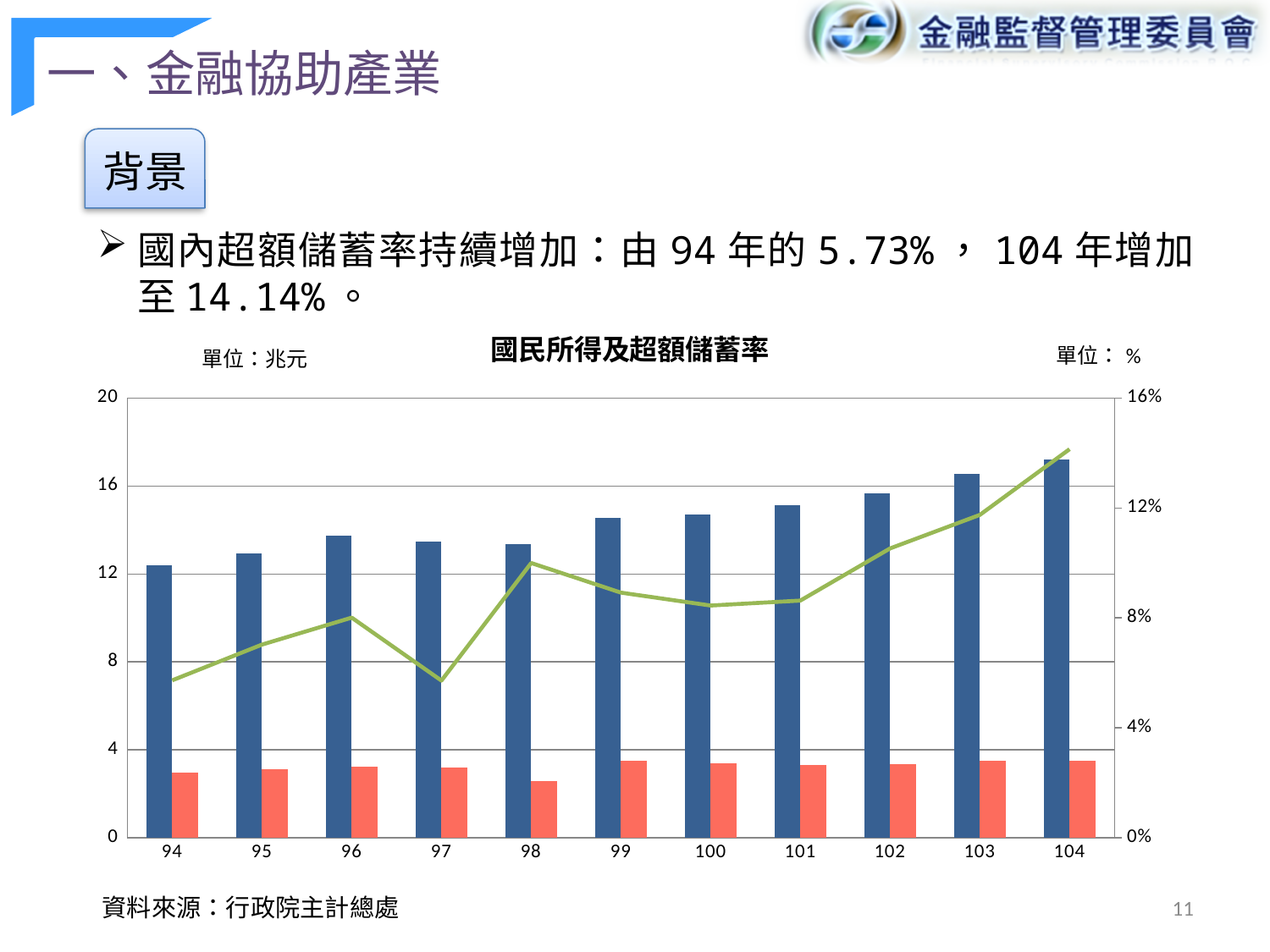
Which year has the shortest red bar? 98 Is the green line value for year 97 greater or less than 8% on the right axis? less Does the green line rise or fall from year 101 to year 104? rise Is the blue bar for year 104 greater or less than 16 on the left axis? greater In which year does the green line reach its highest point? 104 What kind of chart is shown on the slide? A combined bar and line chart How many years are shown on the x axis of the chart? 11 Which year has the tallest blue bar? 104 Which year has the taller blue bar, 102 or 103? 103 Which year has the shortest blue bar? 94 Is the green line value for year 104 greater or less than 12% on the right axis? greater What is the title of the chart? 國民所得及超額儲蓄率